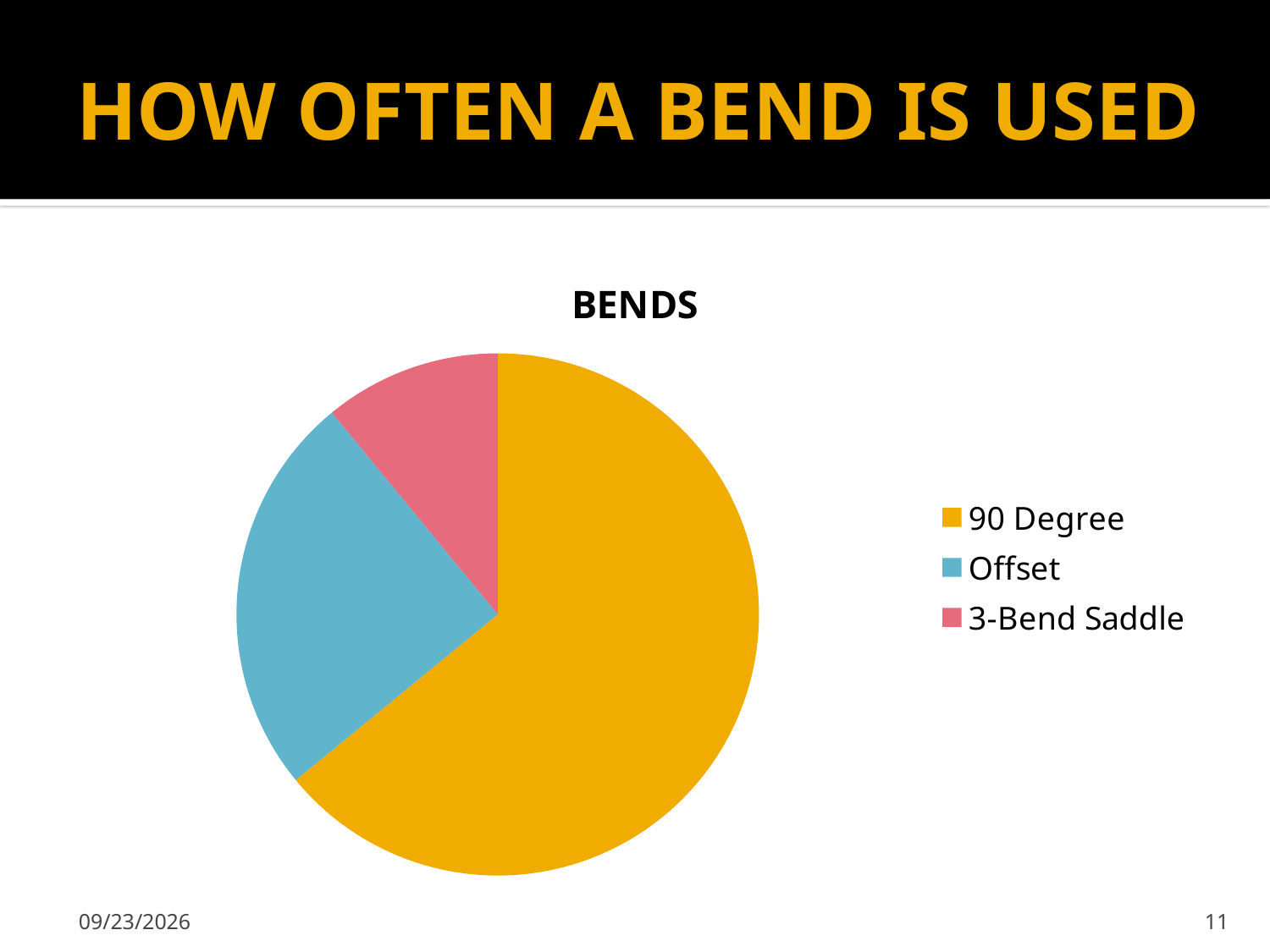
What kind of chart is shown on the slide? Pie chart Which bend type is shown in the legend between 90 Degree and 3-Bend Saddle? Offset Which bend type has the largest slice of the pie? 90 Degree How many entries does the legend list? 3 What is the title of the chart? BENDS Which slice is larger, 90 Degree or Offset? 90 Degree Which bend type has the smallest slice of the pie? 3-Bend Saddle Which slice is larger, Offset or 3-Bend Saddle? Offset How many slices does the pie chart have? 3 Which colour represents the Offset slice in the pie chart? Blue